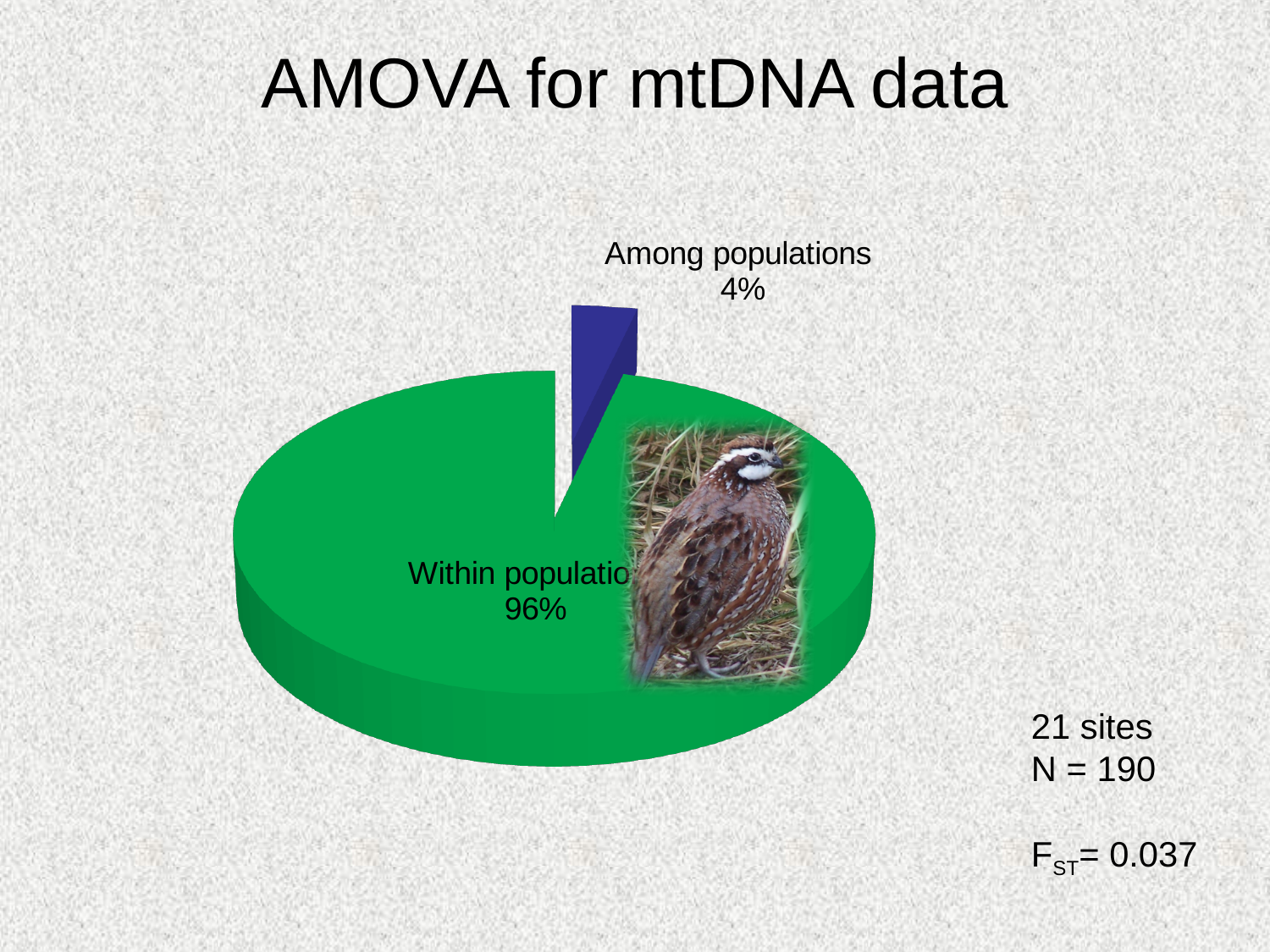
Which is larger: the 'Among populations' slice or the 'Within populations' slice? Within populations What percentage of the pie is labelled 'Within populations'? 96% Which slice of the pie is the smallest? Among populations What kind of chart is shown on the slide? pie chart What is the title of the slide containing the pie chart? AMOVA for mtDNA data What share of the pie does the 'Within populations' slice represent? 96% Which slice of the pie is the largest? Within populations What colour is the 'Among populations' slice? blue How many slices does the pie chart have? 2 What is the difference in percentage points between the 'Within populations' and 'Among populations' slices? 92 What percentage of the pie is labelled 'Among populations'? 4%